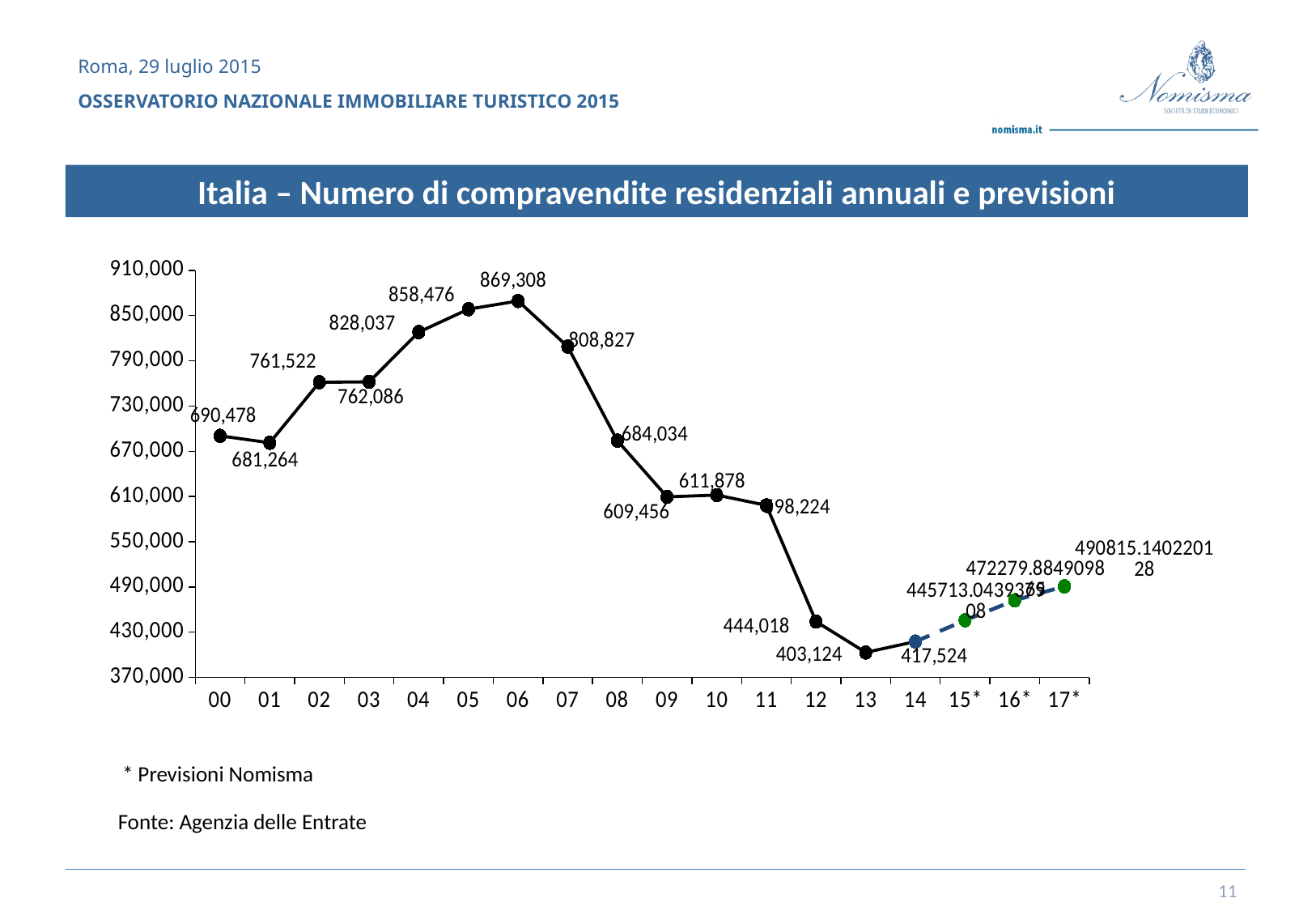
Which year has the lowest value? 13 What is the difference between the values for 06 and 05? 10,832 Which year has the highest value? 06 Is the value for 11 greater or less than 550,000? greater What is the difference between the values for 12 and 13? 40,894 How many years are shown on the x axis? 18 What is the value for 13? 403,124 What is the value for 06? 869,308 What is the value for 00? 690,478 What kind of chart is this? line chart Which is larger, the value for 04 or the value for 07? 04 What is the value for 14? 417,524